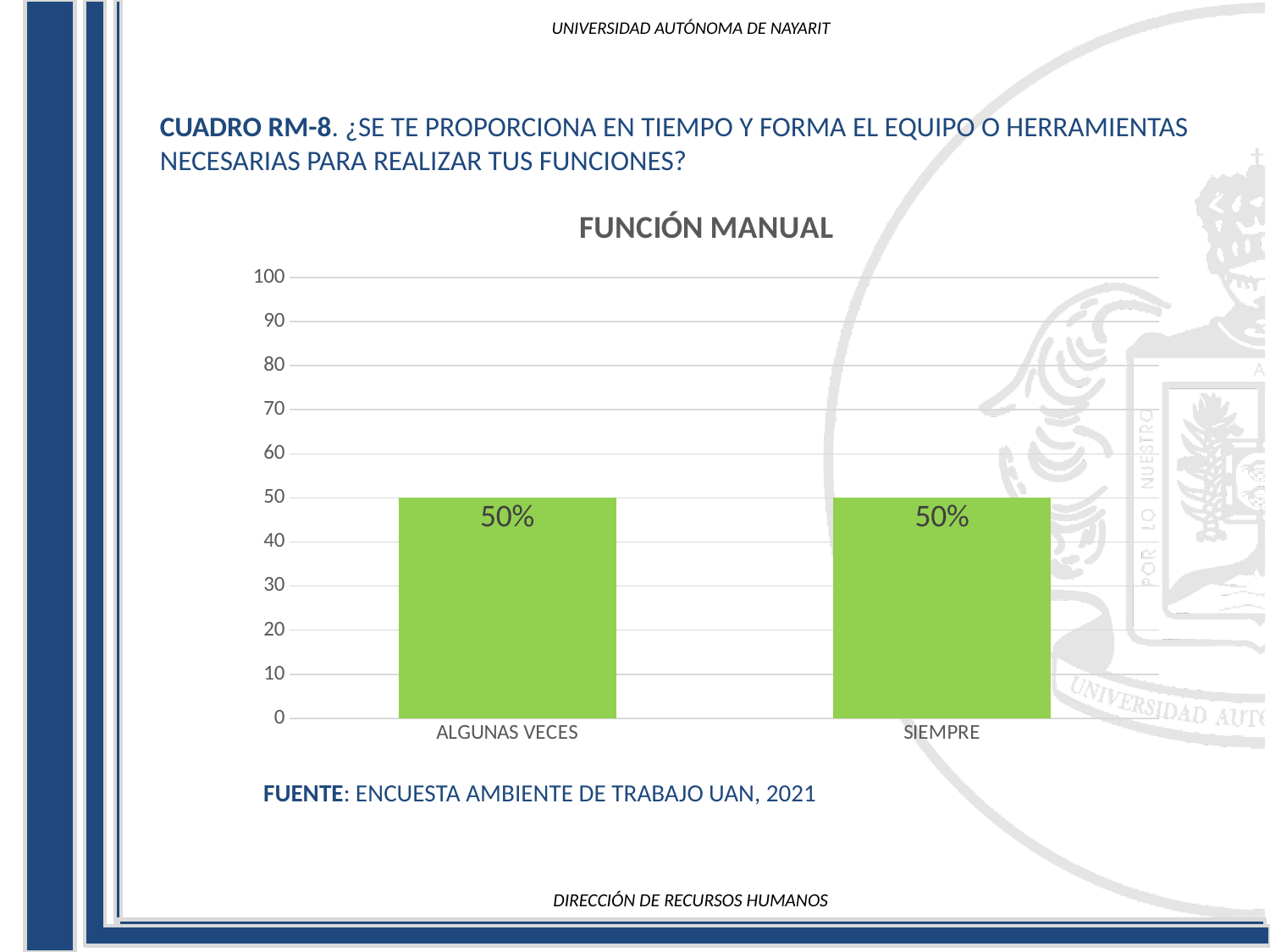
How many categories are shown on the x axis? 2 What is the value for ALGUNAS VECES? 50% Do the values rise, fall or stay the same from ALGUNAS VECES to SIEMPRE? stay the same Is the value for ALGUNAS VECES greater or less than 40? greater What is the title of the chart? FUNCIÓN MANUAL What is the value for SIEMPRE? 50% What kind of chart is shown on the slide? bar chart What is the highest value shown on the y axis? 100 Is the value for SIEMPRE greater or less than 60? less What is the difference between the values for ALGUNAS VECES and SIEMPRE? 0%